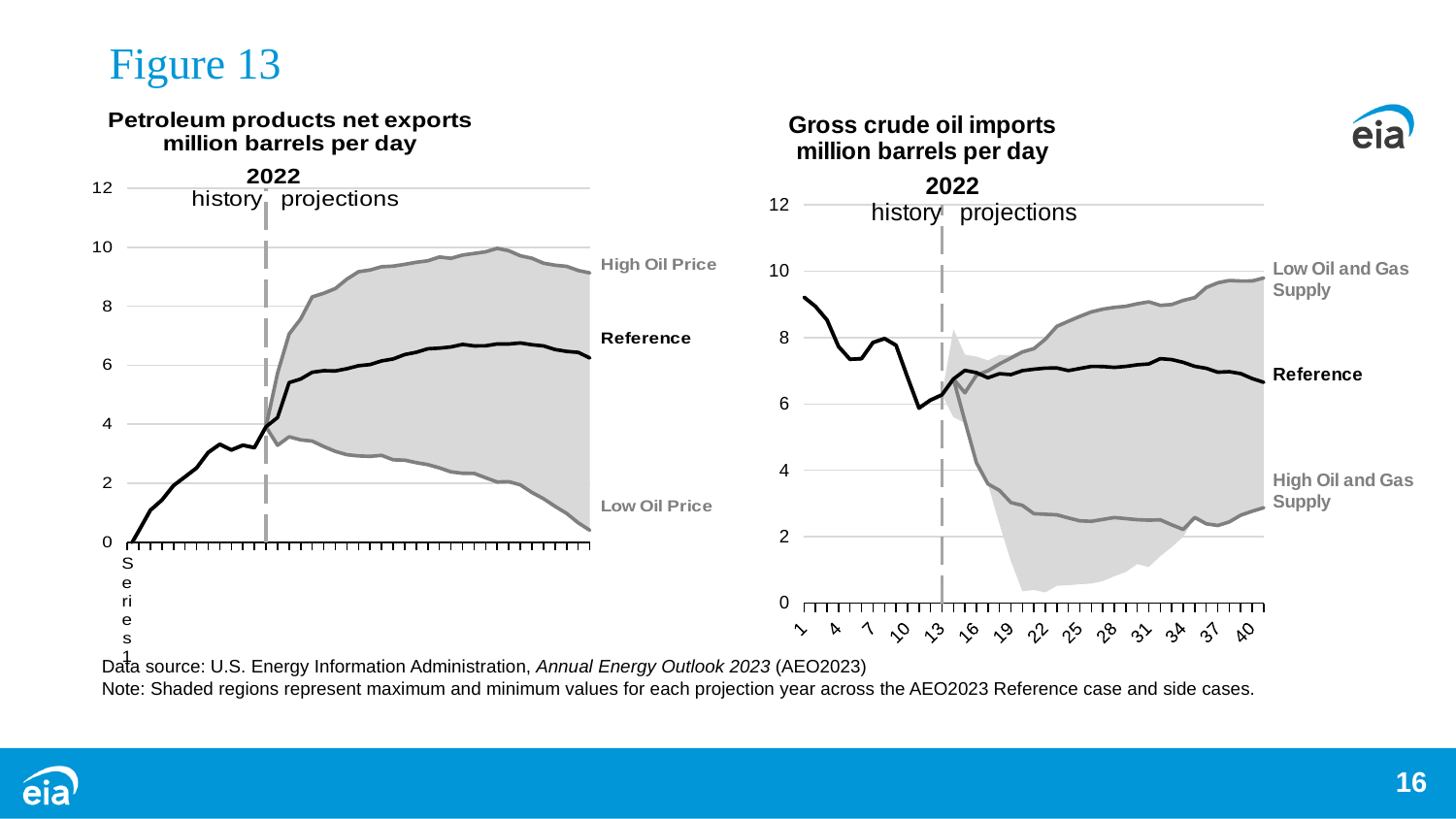
What kind of chart is the 'Petroleum products net exports' chart on the left? line chart In the 'Gross crude oil imports' chart on the right, what year marks the boundary between history and projections? 2022 In the 'Gross crude oil imports' chart, is the Low Oil and Gas Supply line at the end of the projection period greater or less than 8? greater In the 'Petroleum products net exports' chart, is the Reference line at the end of the projection period greater or less than 4? greater In the 'Petroleum products net exports' chart, does the Reference line rise or fall over the history period? rise In the 'Gross crude oil imports' chart, which labeled line is highest at the end of the projection period? Low Oil and Gas Supply In the 'Petroleum products net exports' chart, which is higher at the end of the projection period, High Oil Price or Low Oil Price? High Oil Price In the 'Petroleum products net exports' chart, is the Low Oil Price line at the end of the projection period greater or less than 2? less In the 'Gross crude oil imports' chart, how many labeled lines are shown? 3 In the 'Petroleum products net exports' chart, what unit are the values measured in? million barrels per day